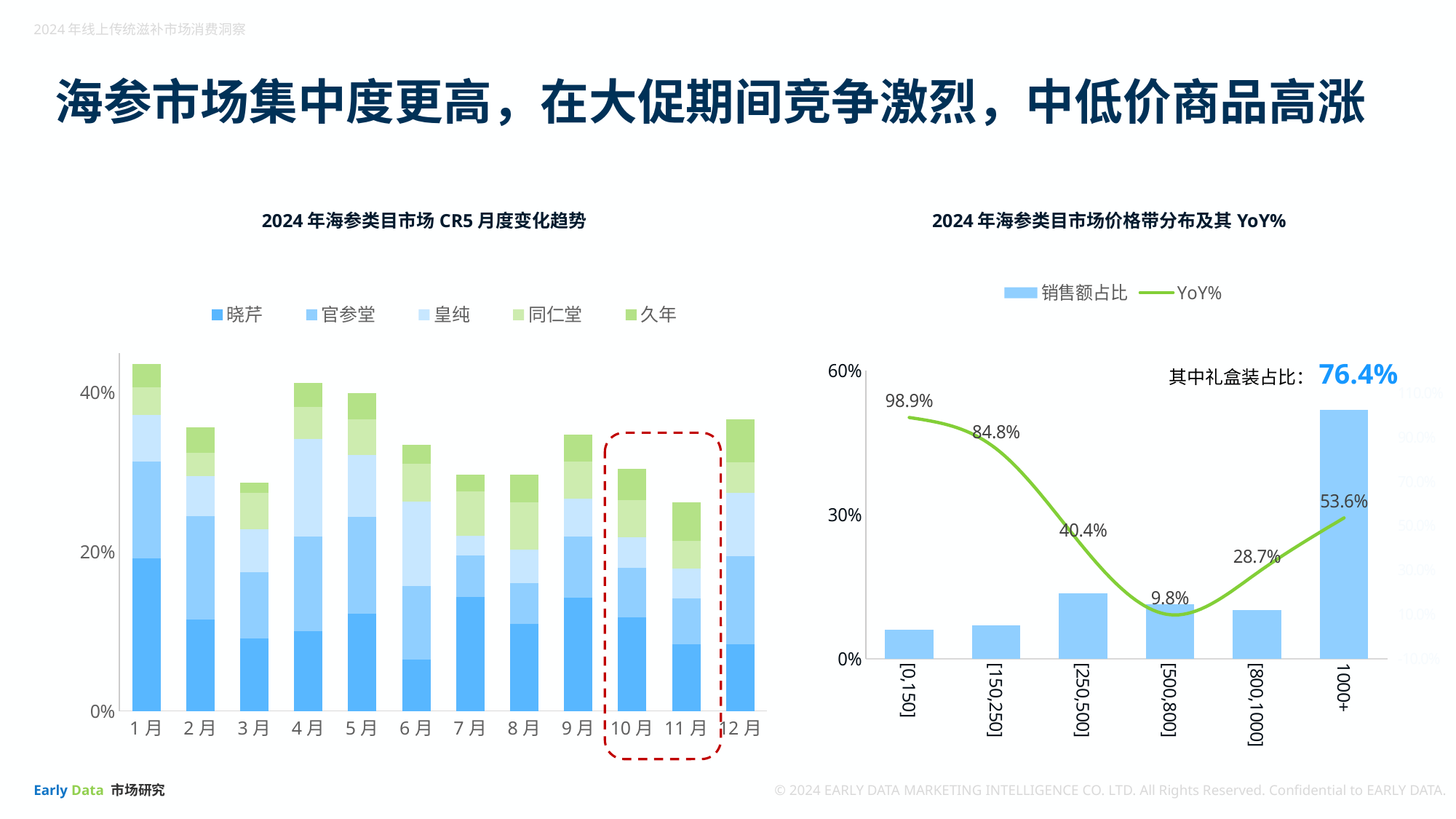
In the chart titled 2024 年海参类目市场价格带分布及其 YoY%, which price band has the lowest YoY%? [500,800] How many series does the legend of the chart titled 2024 年海参类目市场 CR5 月度变化趋势 list? 5 In the chart titled 2024 年海参类目市场价格带分布及其 YoY%, what is the YoY% for the [0,150] price band? 98.9% In the chart titled 2024 年海参类目市场价格带分布及其 YoY%, what is the YoY% for the [500,800] price band? 9.8% In the chart titled 2024 年海参类目市场 CR5 月度变化趋势, is the total for 11 月 greater or less than 40%? less In the chart titled 2024 年海参类目市场价格带分布及其 YoY%, is the 销售额占比 for 1000+ greater or less than 30%? greater In the chart titled 2024 年海参类目市场 CR5 月度变化趋势, which month has the highest total CR5? 1 月 In the chart titled 2024 年海参类目市场价格带分布及其 YoY%, which price band has the highest YoY%? [0,150] What kind of chart is the chart titled 2024 年海参类目市场 CR5 月度变化趋势? Stacked bar chart In the chart titled 2024 年海参类目市场价格带分布及其 YoY%, what is the difference between the YoY% of [0,150] and [150,250]? 14.1 percentage points In the chart titled 2024 年海参类目市场价格带分布及其 YoY%, what is the YoY% for the 1000+ price band? 53.6% In the chart titled 2024 年海参类目市场价格带分布及其 YoY%, which price band has the largest 销售额占比 bar? 1000+